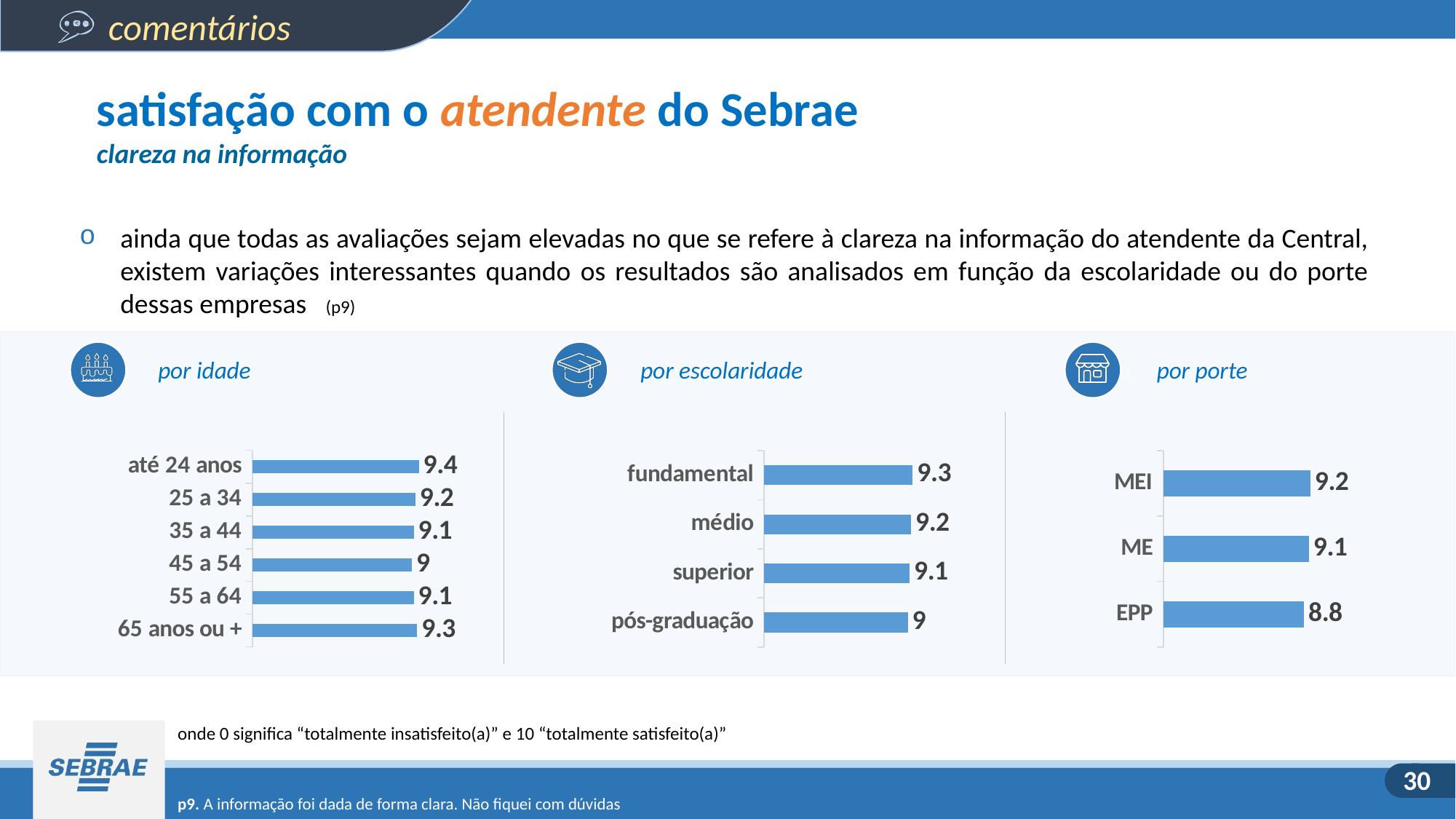
In the 'por escolaridade' chart, how many categories are shown? 4 What kind of chart is the 'por porte' chart? bar chart In the 'por idade' chart, what is the value for 'até 24 anos'? 9.4 In the 'por idade' chart, which age group has the lowest value? 45 a 54 In the 'por porte' chart, which category has the lowest value? EPP In the 'por porte' chart, what is the difference between 'MEI' and 'EPP'? 0.4 In the 'por idade' chart, what is the difference between 'até 24 anos' and '45 a 54'? 0.4 In the 'por idade' chart, how many age categories are shown? 6 In the 'por escolaridade' chart, do the values rise or fall from 'fundamental' to 'pós-graduação'? fall In the 'por escolaridade' chart, which category has the highest value? fundamental In the 'por escolaridade' chart, what is the value for 'médio'? 9.2 In the 'por porte' chart, what is the value for 'EPP'? 8.8